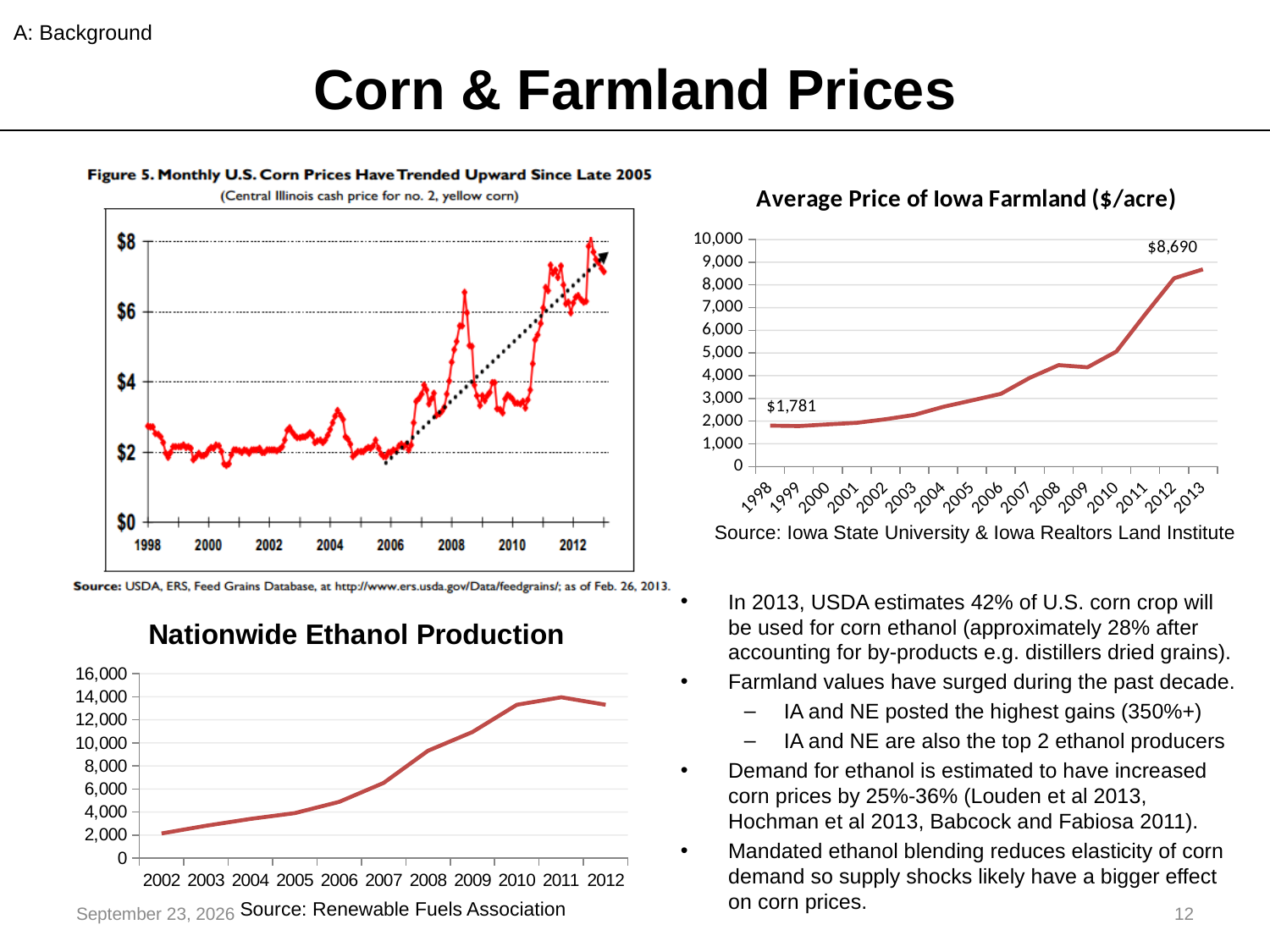
On the Nationwide Ethanol Production chart, which year has the highest value? 2011 On the Nationwide Ethanol Production chart, which year has the lowest value? 2002 On the Average Price of Iowa Farmland chart, what is the difference between the 2013 and 1998 labeled values? $6,909 On the Nationwide Ethanol Production chart, is the value for 2010 greater or less than 12,000? greater On the Average Price of Iowa Farmland chart, do values generally rise or fall from 1998 to 2013? rise What kind of chart is the Nationwide Ethanol Production chart? line chart On the Average Price of Iowa Farmland chart, what is the value labeled for 2013? $8,690 On the Average Price of Iowa Farmland chart, is the value for 2008 greater or less than 4,000? greater On the Average Price of Iowa Farmland chart, what is the value labeled for 1998? $1,781 On the Nationwide Ethanol Production chart, how many years are shown on the x axis? 11 On the Average Price of Iowa Farmland chart, how many years are shown on the x axis? 16